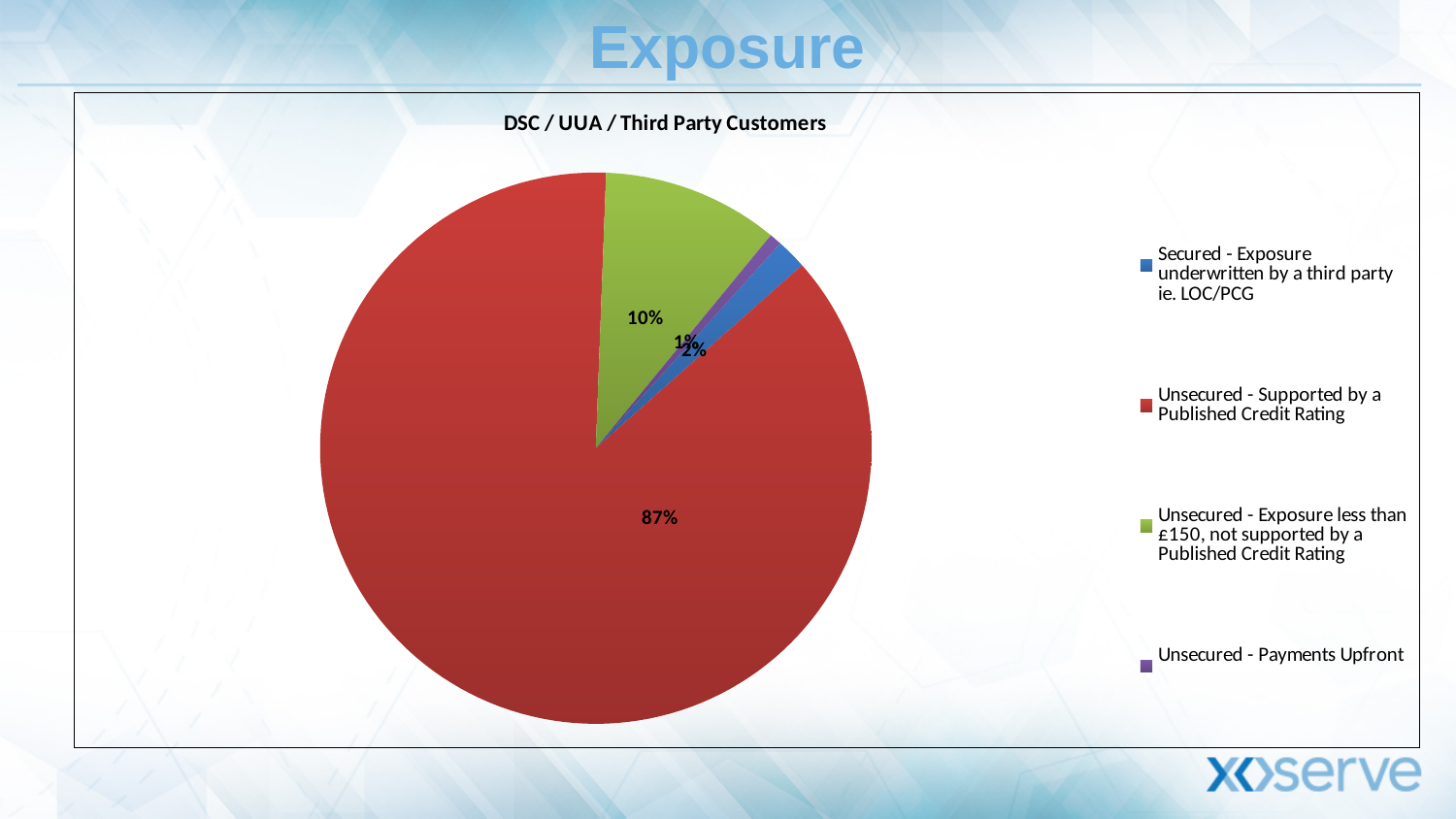
What is the difference in percentage points between the 'Unsecured - Supported by a Published Credit Rating' slice and the 'Unsecured - Exposure less than £150' slice? 77 How many entries does the legend list? 4 What is the title of the chart? DSC / UUA / Third Party Customers What share of the pie is 'Unsecured - Payments Upfront'? 1% What share of the pie is 'Secured - Exposure underwritten by a third party ie. LOC/PCG'? 2% Which category has the largest slice of the pie? Unsecured - Supported by a Published Credit Rating How many slices does the pie chart have? 4 What kind of chart is shown on the slide? pie chart What share of the pie is 'Unsecured - Supported by a Published Credit Rating'? 87% Which colour represents 'Unsecured - Supported by a Published Credit Rating' in the pie chart? red Which category has the smallest slice of the pie? Unsecured - Payments Upfront